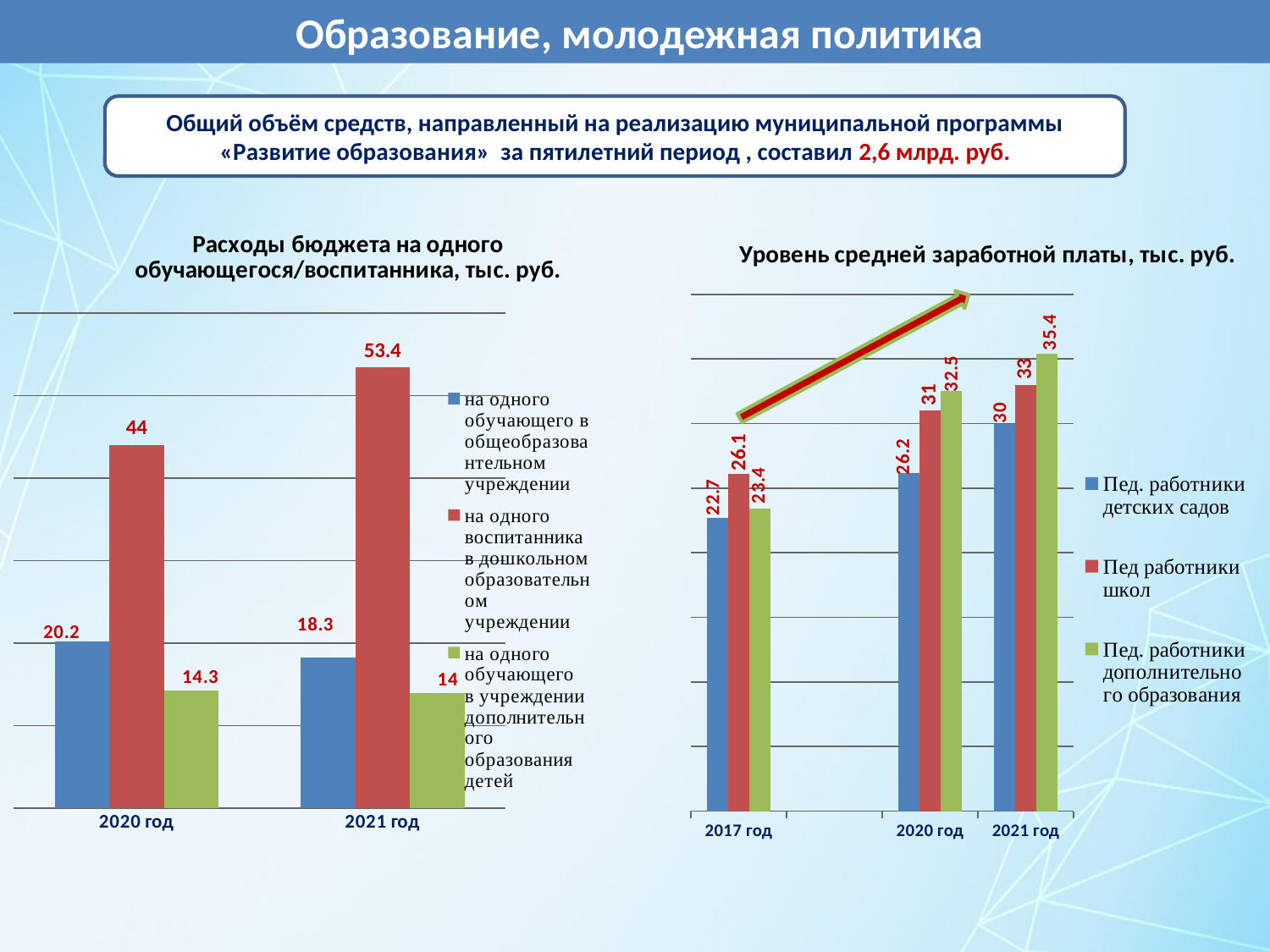
In the chart 'Уровень средней заработной платы, тыс. руб.', which group has the lowest value in 2020 год? Пед. работники детских садов In the chart 'Расходы бюджета на одного обучающегося/воспитанника, тыс. руб.', did the value for 'на одного обучающего в общеобразовательном учреждении' rise or fall from 2020 год to 2021 год? fall What type of chart is 'Уровень средней заработной платы, тыс. руб.'? bar chart In the chart 'Уровень средней заработной платы, тыс. руб.', how many years are shown on the x axis? 3 In the chart 'Расходы бюджета на одного обучающегося/воспитанника, тыс. руб.', what is the value for 'на одного обучающего в общеобразовательном учреждении' in 2020 год? 20.2 In the chart 'Уровень средней заработной платы, тыс. руб.', what is the difference between 'Пед работники школ' in 2021 год and in 2017 год? 6.9 In the chart 'Расходы бюджета на одного обучающегося/воспитанника, тыс. руб.', how many series does the legend list? 3 In the chart 'Расходы бюджета на одного обучающегося/воспитанника, тыс. руб.', by how much did the value for 'на одного воспитанника в дошкольном образовательном учреждении' change from 2020 год to 2021 год? 9.4 In the chart 'Расходы бюджета на одного обучающегося/воспитанника, тыс. руб.', what is the value for 'на одного воспитанника в дошкольном образовательном учреждении' in 2021 год? 53.4 In the chart 'Расходы бюджета на одного обучающегося/воспитанника, тыс. руб.', which series has the highest value in 2021 год? на одного воспитанника в дошкольном образовательном учреждении In the chart 'Уровень средней заработной платы, тыс. руб.', what is the value for 'Пед. работники дополнительного образования' in 2021 год? 35.4 In the chart 'Уровень средней заработной платы, тыс. руб.', what is the value for 'Пед. работники детских садов' in 2017 год? 22.7